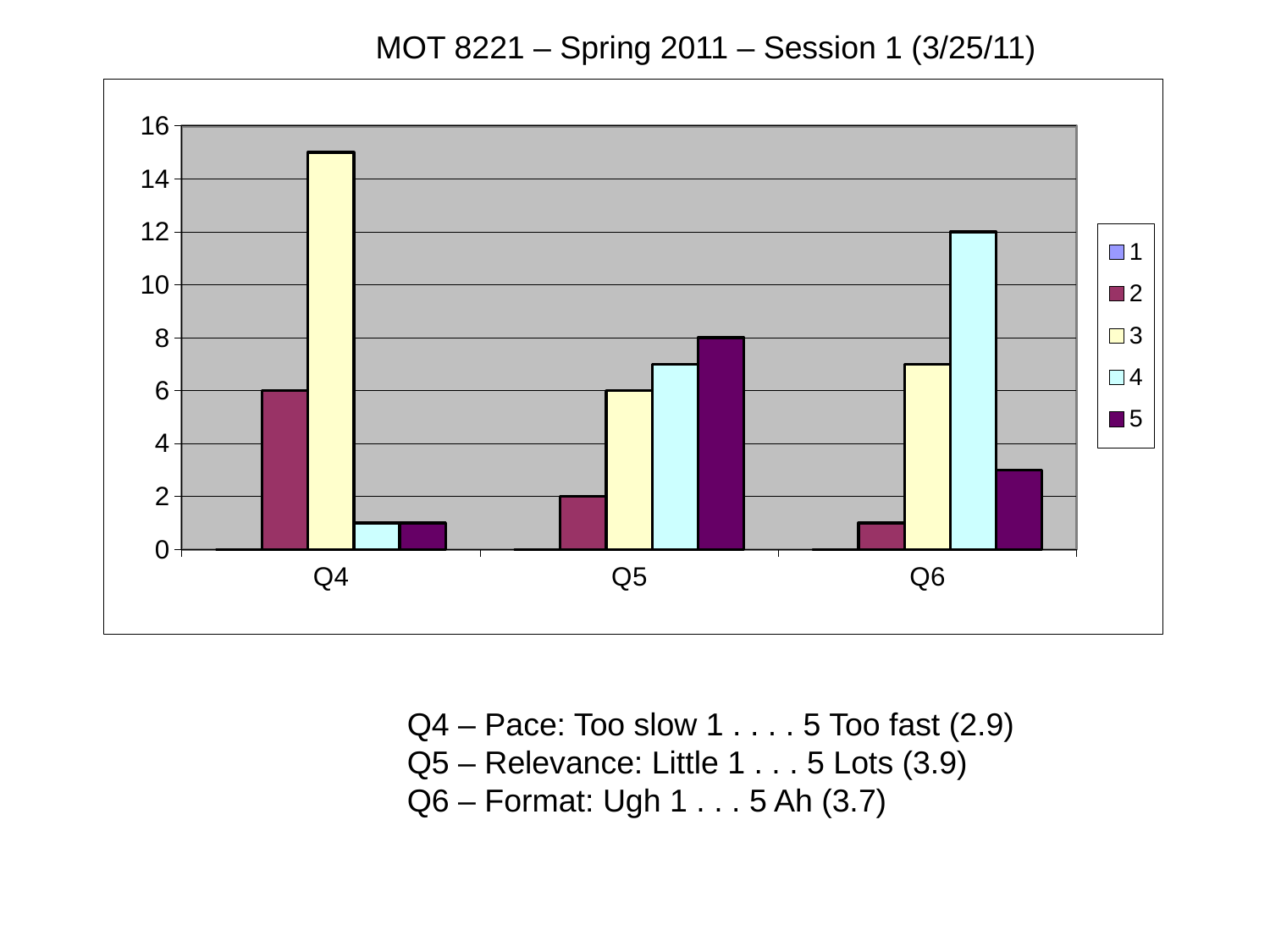
How many categories are shown on the x axis? 3 What is the value for series 4 in category Q6? 12 What is the value for series 5 in category Q5? 8 Which is larger: series 3 in Q6 or series 5 in Q6? series 3 in Q6 What kind of chart is shown on the slide? bar chart What is the value for series 2 in category Q4? 6 Is the value for series 3 in category Q4 greater or less than 14? greater Which series has the highest value in category Q6? 4 What is the value for series 2 in category Q5? 2 What is the title of the slide above the chart? MOT 8221 – Spring 2011 – Session 1 (3/25/11) How many series does the legend list? 5 Which series has the highest value in category Q4? 3